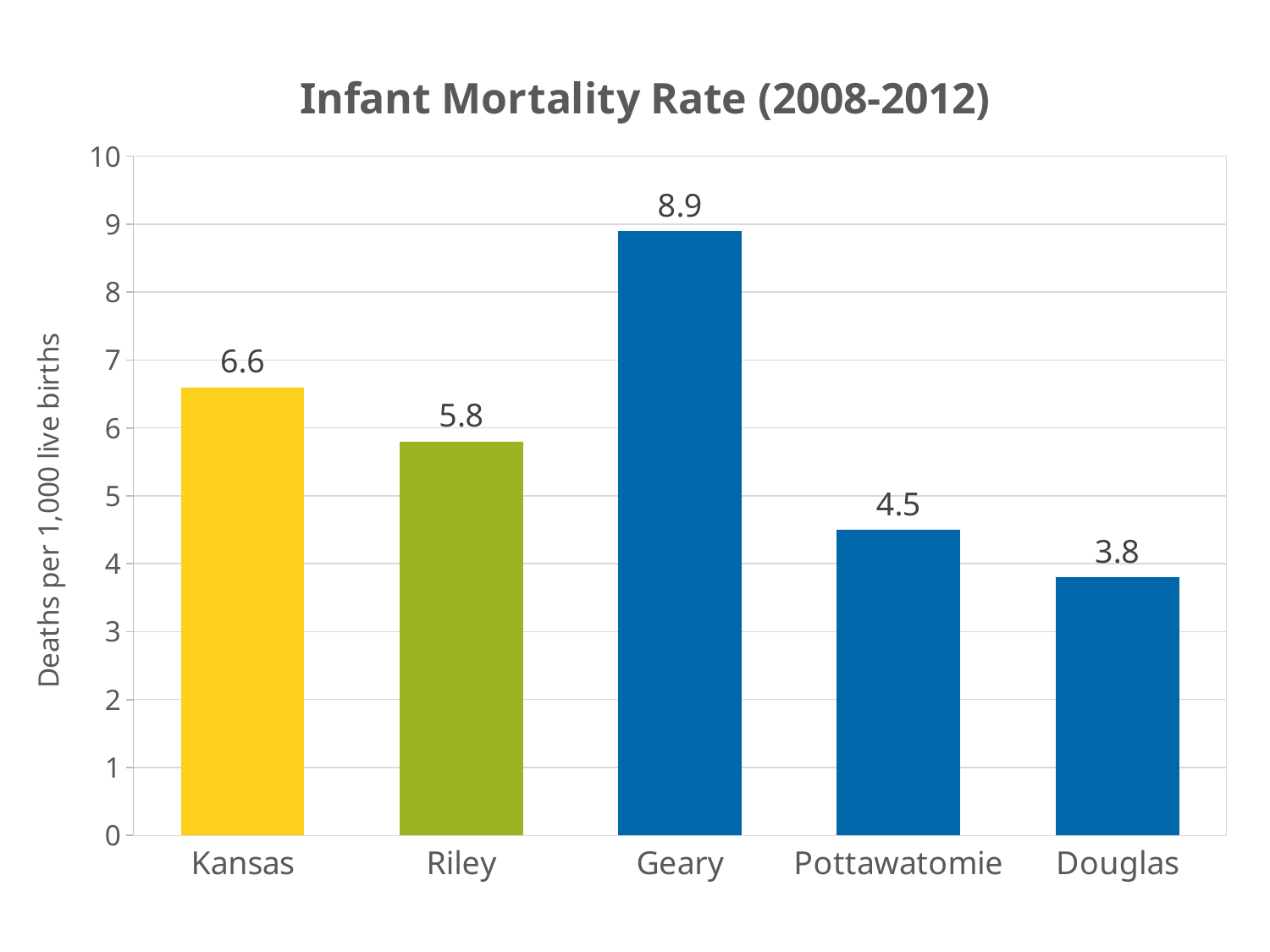
What is the difference between the infant mortality rates of Kansas and Riley? 0.8 What is the difference between the infant mortality rates of Geary and Douglas? 5.1 Which category has the lowest infant mortality rate? Douglas What kind of chart is shown on the slide? bar chart What is the infant mortality rate for Kansas? 6.6 Is the value for Pottawatomie greater or less than 5? less Which has a higher infant mortality rate, Riley or Pottawatomie? Riley How many categories are shown on the x axis? 5 Which category has the highest infant mortality rate? Geary What is the infant mortality rate for Douglas? 3.8 What is the title of the chart? Infant Mortality Rate (2008-2012) What is the infant mortality rate for Geary? 8.9